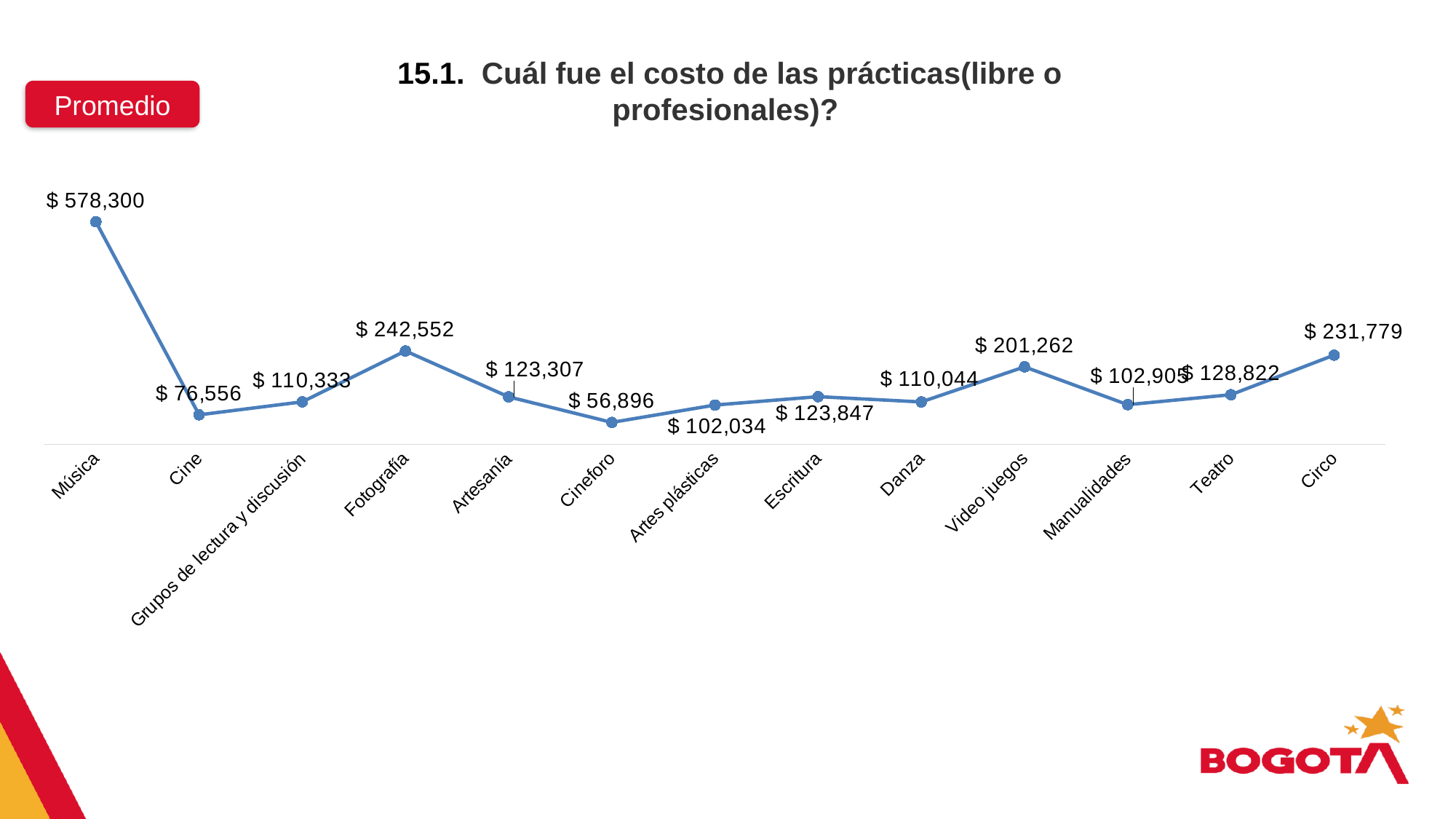
Which is larger, the value for Circo or the value for Teatro? Circo What is the value for Fotografía? $ 242,552 What label appears in the red box at the top left of the slide? Promedio What kind of chart is shown on the slide? Line chart What is the difference between the values for Fotografía and Circo? $ 10,773 How many categories are plotted on the chart? 13 Which category has the highest value? Música What is the value for Cineforo? $ 56,896 What is the value for Video juegos? $ 201,262 Which category has the lowest value? Cineforo What is the difference between the values for Música and Cine? $ 501,744 What is the value for Música? $ 578,300